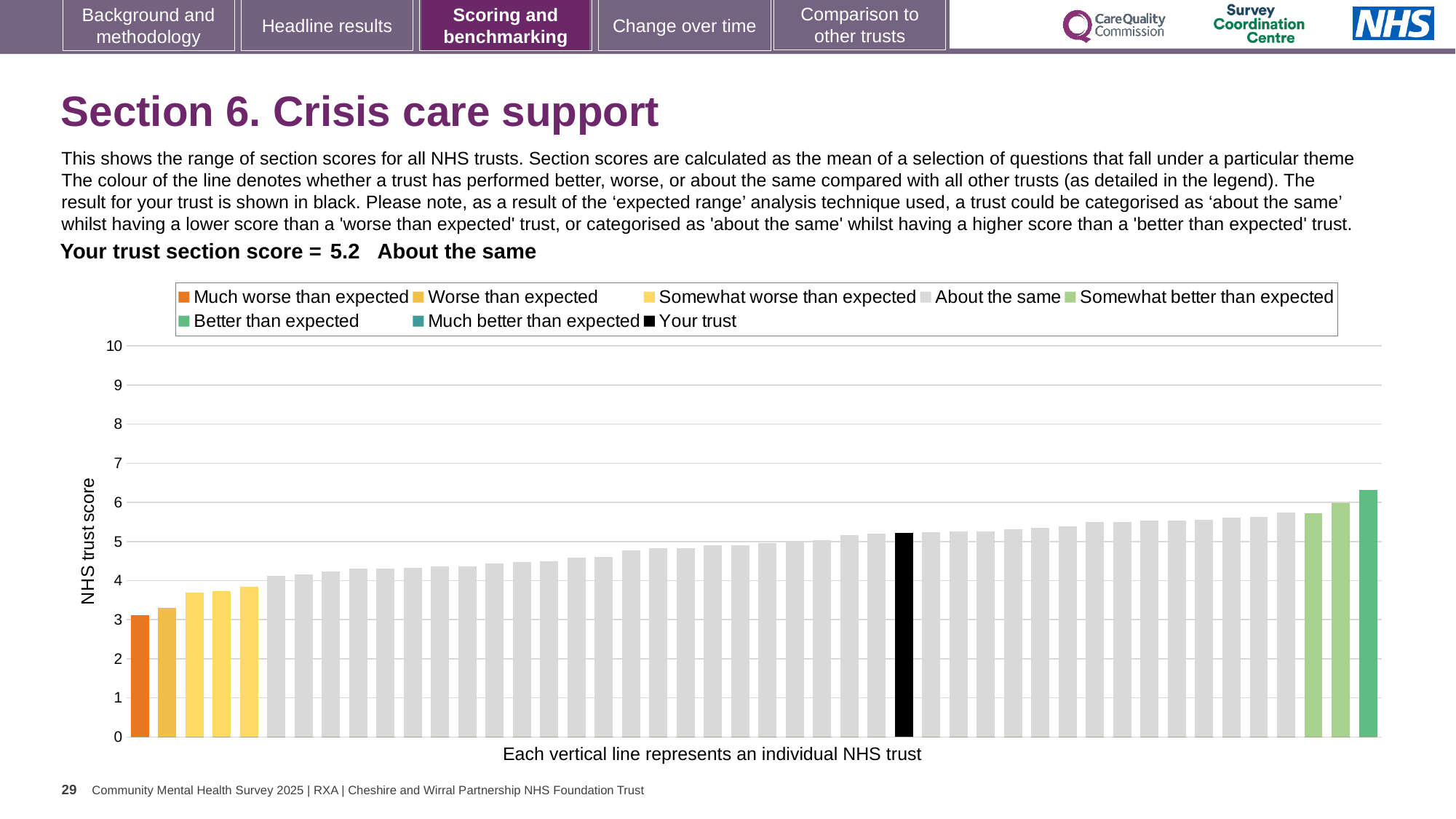
What is the label on the vertical axis of the chart? NHS trust score Do the bar values rise or fall from left to right along the x axis? rise How many entries does the chart legend list? 8 Is the value of the tallest bar on the far right greater or less than 6? greater What is the section score for your trust shown on the slide? 5.2 What kind of chart is shown on the slide? bar chart How many bars are coloured as 'Somewhat better than expected'? 2 Is the value of the lowest bar (the orange one on the far left) greater or less than 4? less Which legend category does the tallest bar belong to? Better than expected Which legend category does the shortest bar belong to? Much worse than expected Is the value of the black 'Your trust' bar greater or less than 5? greater